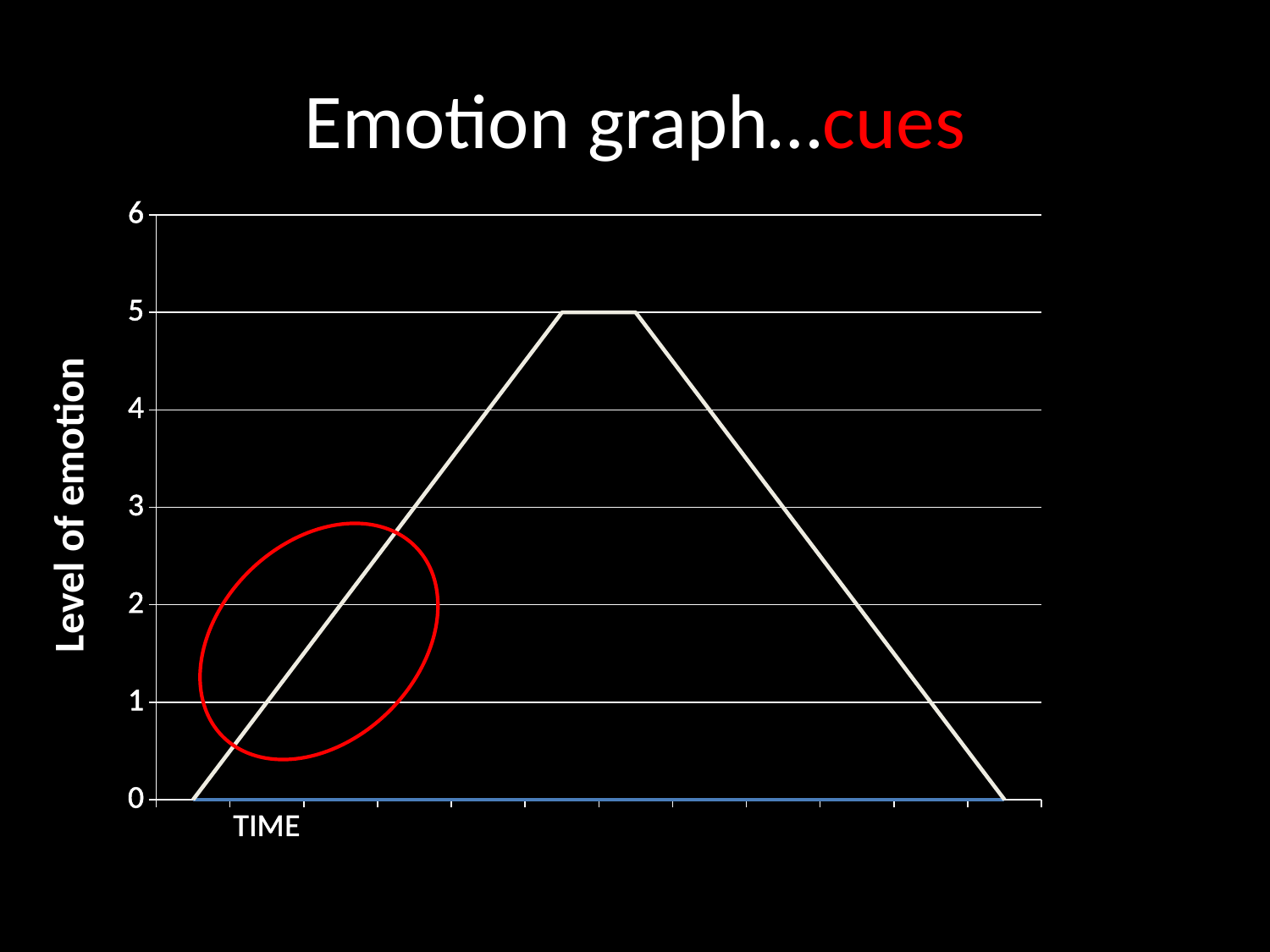
What is the highest level of emotion reached by the line? 5 Is the peak level of emotion greater or less than 6? less What is the title of the x axis? TIME At what level of emotion does the line end on the right? 0 Does the line rise or fall along the x axis before it reaches its plateau? rise After the plateau, does the line rise or fall along the x axis? fall What is the difference between the peak level of emotion and the starting level? 5 Is the peak level of emotion greater or less than 4? greater At what level of emotion does the line start on the left? 0 What kind of chart is shown on the slide? line chart What is the title of the y axis? Level of emotion What is the lowest level of emotion shown by the line? 0